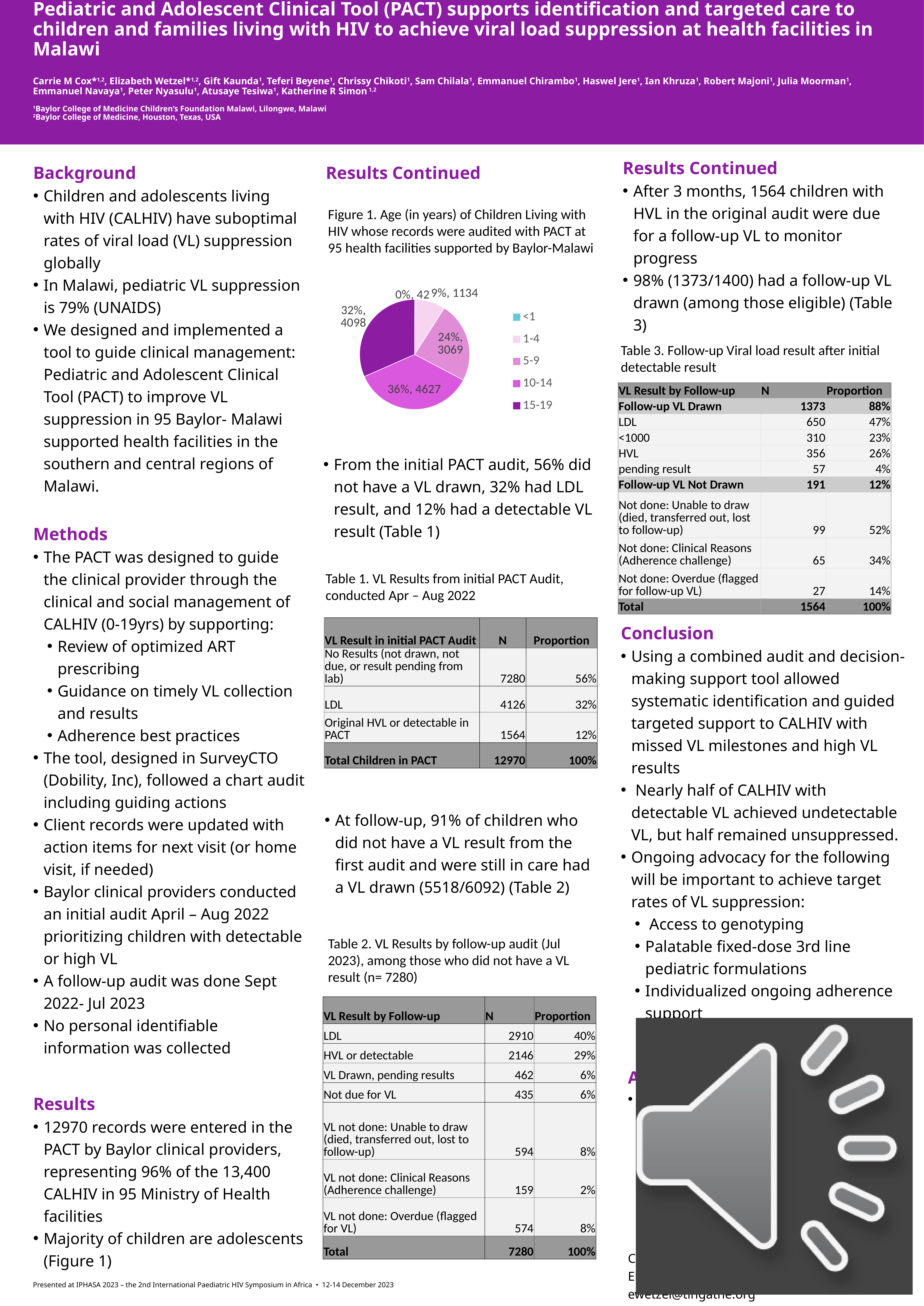
In Figure 1, what percentage of children were aged 15-19? 32% In Figure 1, which age group has the smallest slice? <1 In Figure 1, how many children were in the 5-9 age group? 3069 In Figure 1, how many children were in the 10-14 age group? 4627 In Figure 1, what is the total number of children across all age groups? 12970 What type of chart is Figure 1? pie chart In Figure 1, which age group has the largest slice? 10-14 In Figure 1, how many children were under 1 year old? 42 In Figure 1, which age group has more children: 5-9 or 1-4? 5-9 How many age groups does the legend of Figure 1 list? 5 In Figure 1, what share of the pie is the 1-4 age group? 9% In Figure 1, how many more children were aged 10-14 than 15-19? 529